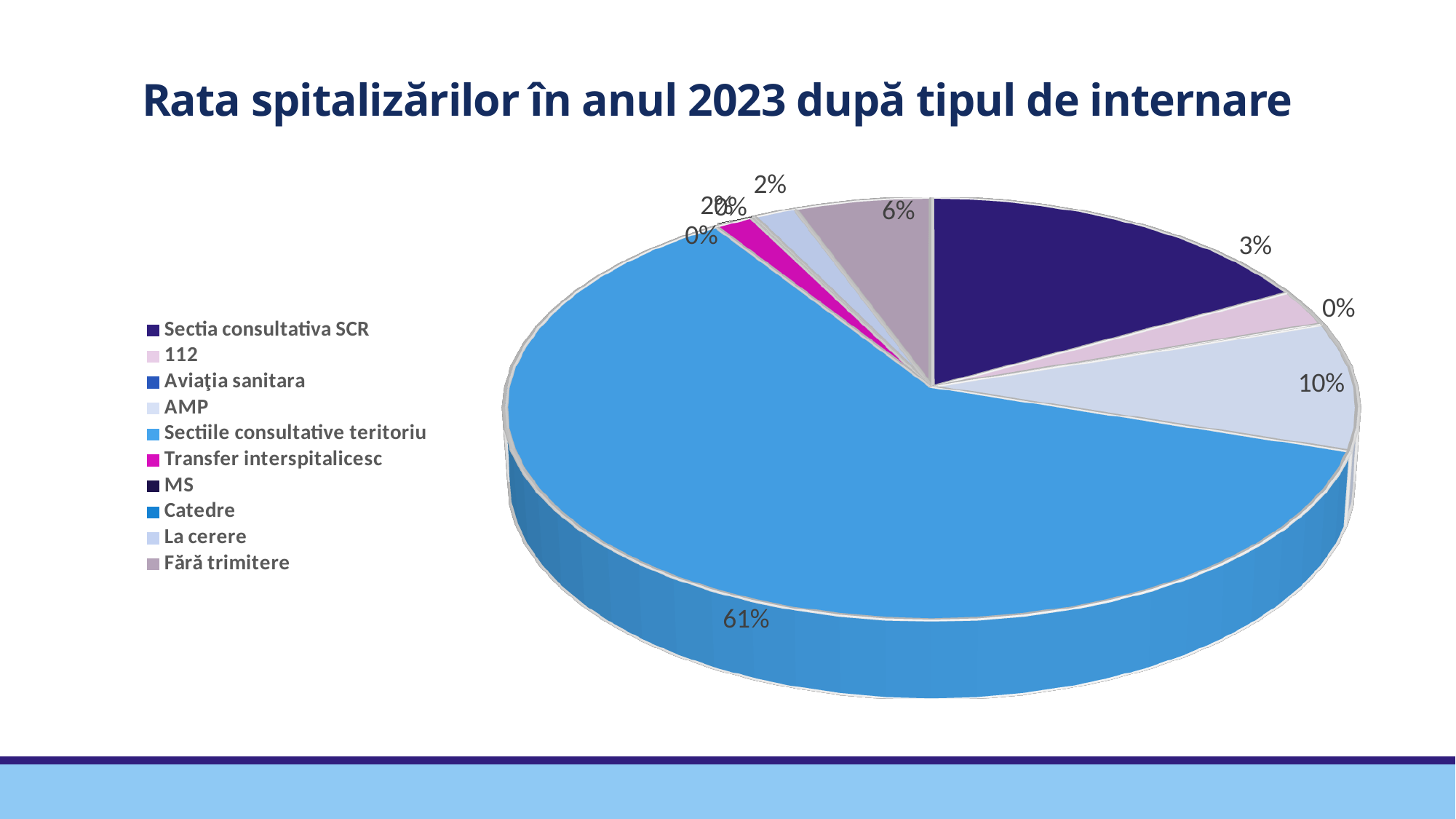
What is the difference in percentage points between Sectiile consultative teritoriu and AMP? 51 What share of the pie does Sectiile consultative teritoriu have? 61% Which legend entry is listed last? Fără trimitere What kind of chart is shown on the slide? pie chart What is the value shown for AMP? 10% Which category has the largest slice of the pie? Sectiile consultative teritoriu Which is larger, the slice for Sectiile consultative teritoriu or the slice for AMP? Sectiile consultative teritoriu How many categories does the legend list? 10 Is the share for Sectiile consultative teritoriu greater or less than 50%? greater What is the title of the chart? Rata spitalizărilor în anul 2023 după tipul de internare